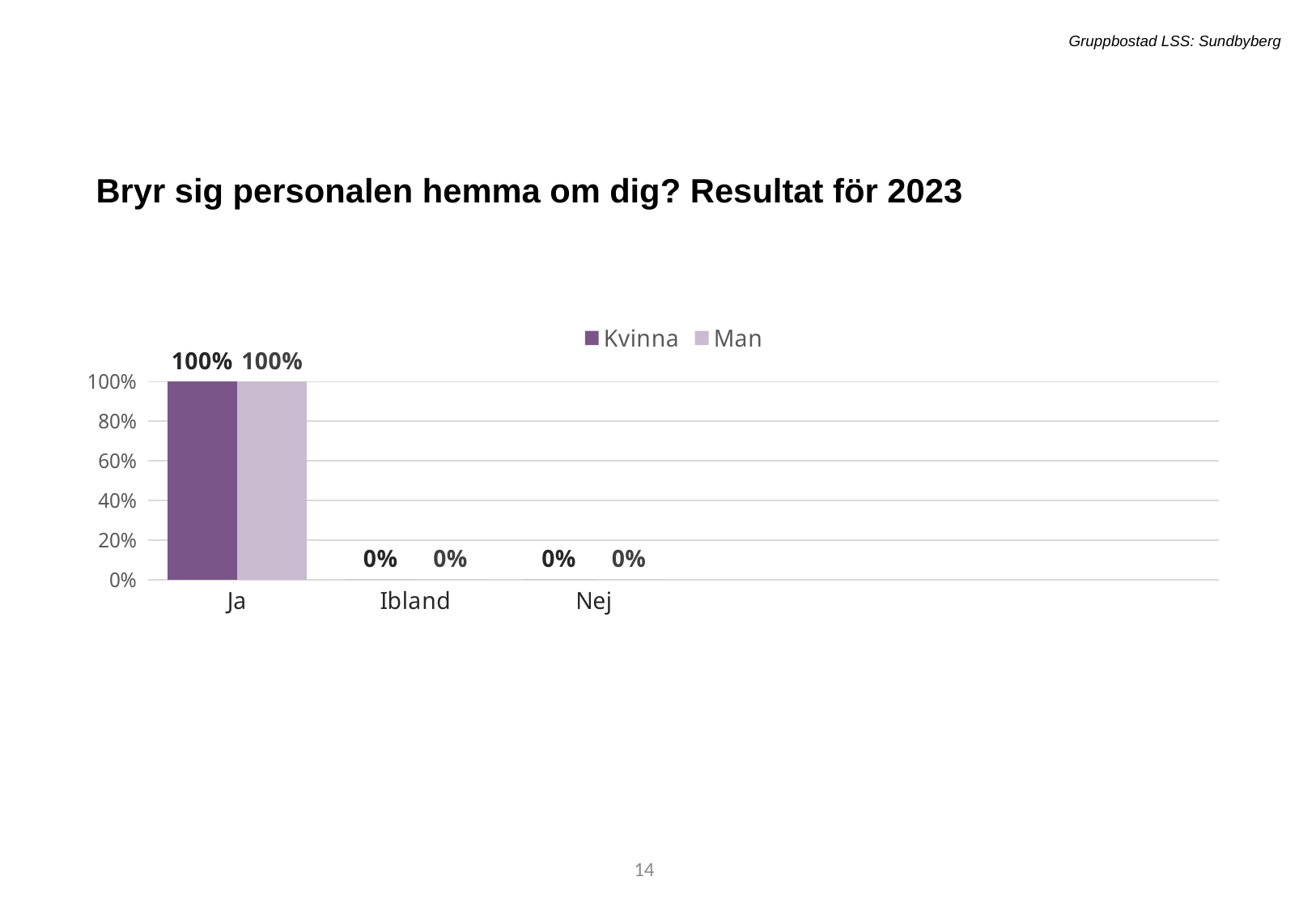
What is the value for Kvinna in the Ja category? 100% What is the value for Man in the Ibland category? 0% Which category has the highest value for Man? Ja How many series does the legend list? 2 Which is larger: the Man value for Ja or the Man value for Ibland? Ja How many categories are shown on the x axis? 3 Do the Kvinna values rise or fall from Ja to Nej along the x axis? Fall What are the two series named in the legend? Kvinna and Man What kind of chart is shown on the slide? Bar chart What is the title of the slide? Bryr sig personalen hemma om dig? Resultat för 2023 What is the value for Kvinna in the Nej category? 0% What is the difference between the Kvinna value for Ja and the Kvinna value for Nej? 100%